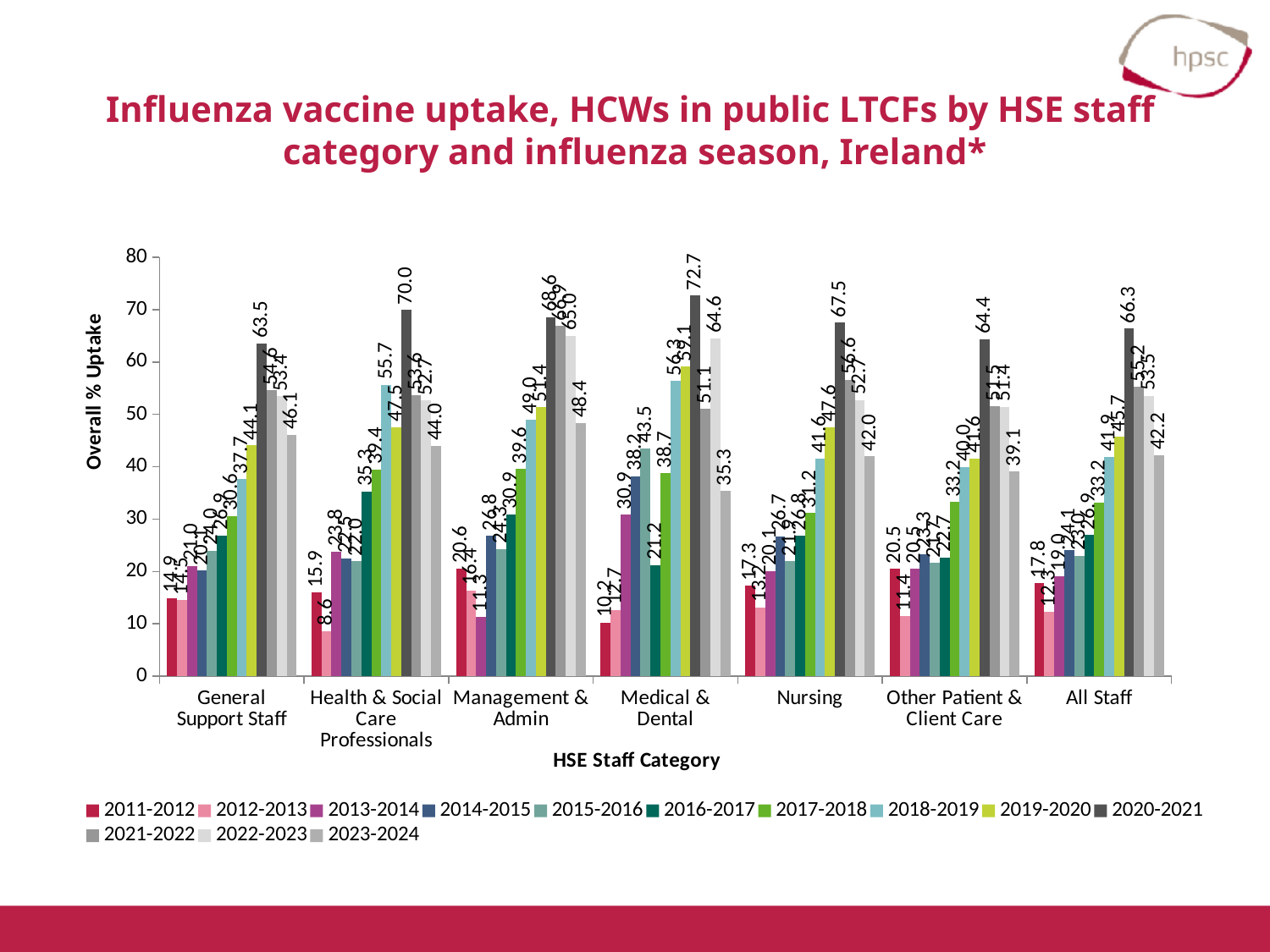
Which HSE staff category has the lowest uptake in the 2012-2013 season? Health & Social Care Professionals How many HSE staff categories are shown on the x axis? 7 Which HSE staff category has the highest uptake in the 2020-2021 season? Medical & Dental What is the influenza vaccine uptake for Medical & Dental staff in the 2020-2021 season? 72.7 What kind of chart is shown on the slide? bar chart Is the 2023-2024 uptake for Medical & Dental staff greater or less than 40? less How many influenza seasons does the legend list? 13 What is the uptake value for Health & Social Care Professionals in the 2020-2021 season? 70.0 In the 2020-2021 season, which has the higher uptake: Nursing or Other Patient & Client Care? Nursing What is the uptake value for All Staff in the 2023-2024 season? 42.2 For All Staff, how much higher is the 2020-2021 uptake than the 2023-2024 uptake? 24.1 What is the title of the vertical axis? Overall % Uptake